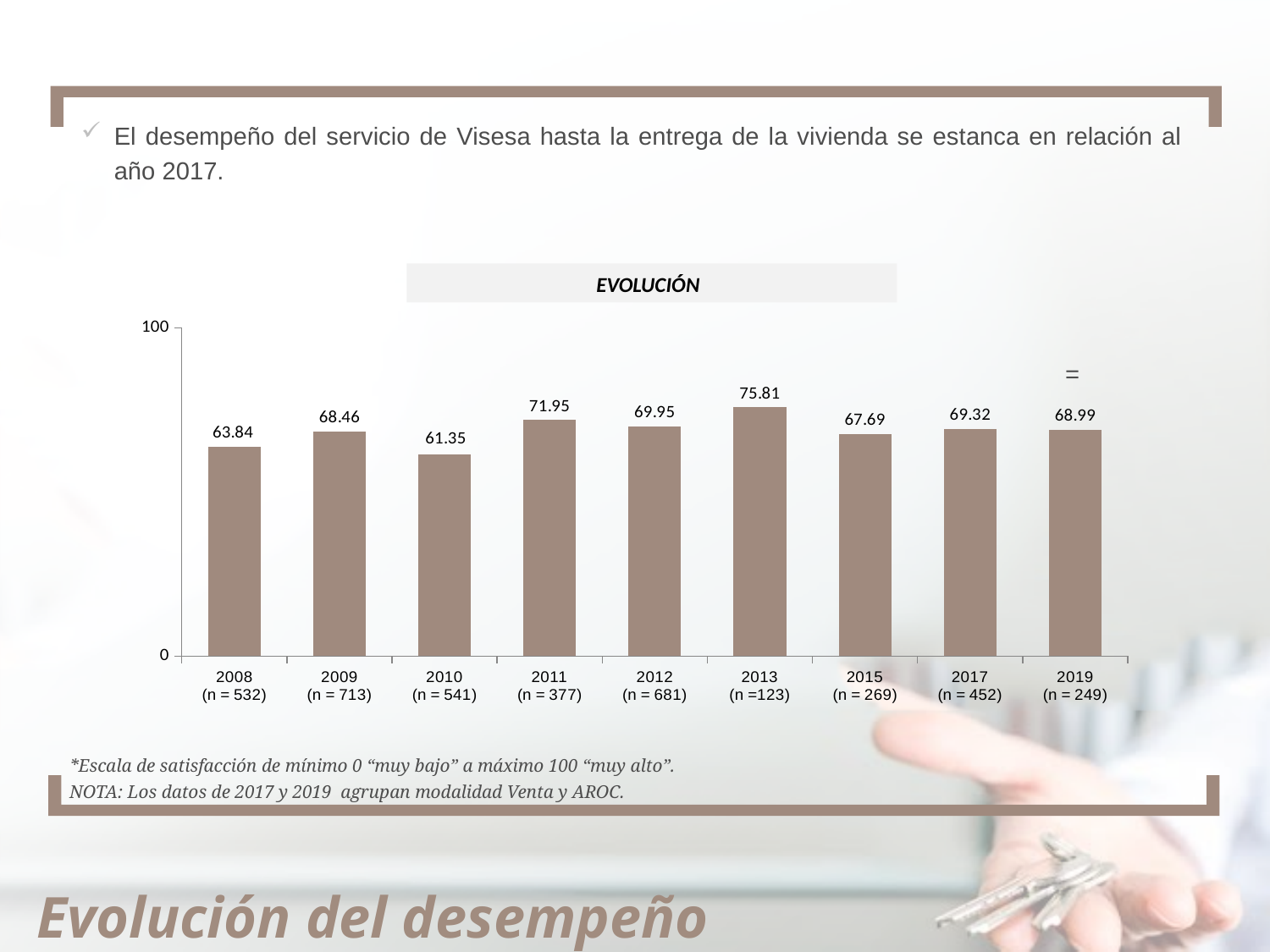
Which year has the lowest value? 2010 What is the difference between the values for 2013 and 2010? 14.46 How many years are shown on the x axis? 9 What kind of chart is shown? bar chart Which year has the highest value? 2013 What is the difference between the values for 2019 and 2017? 0.33 Which is larger, the value for 2011 or the value for 2012? 2011 What is the title of the chart? EVOLUCIÓN Is the value for 2008 greater or less than 100? less What is the value for 2010? 61.35 What is the value for 2019? 68.99 What is the value for 2013? 75.81